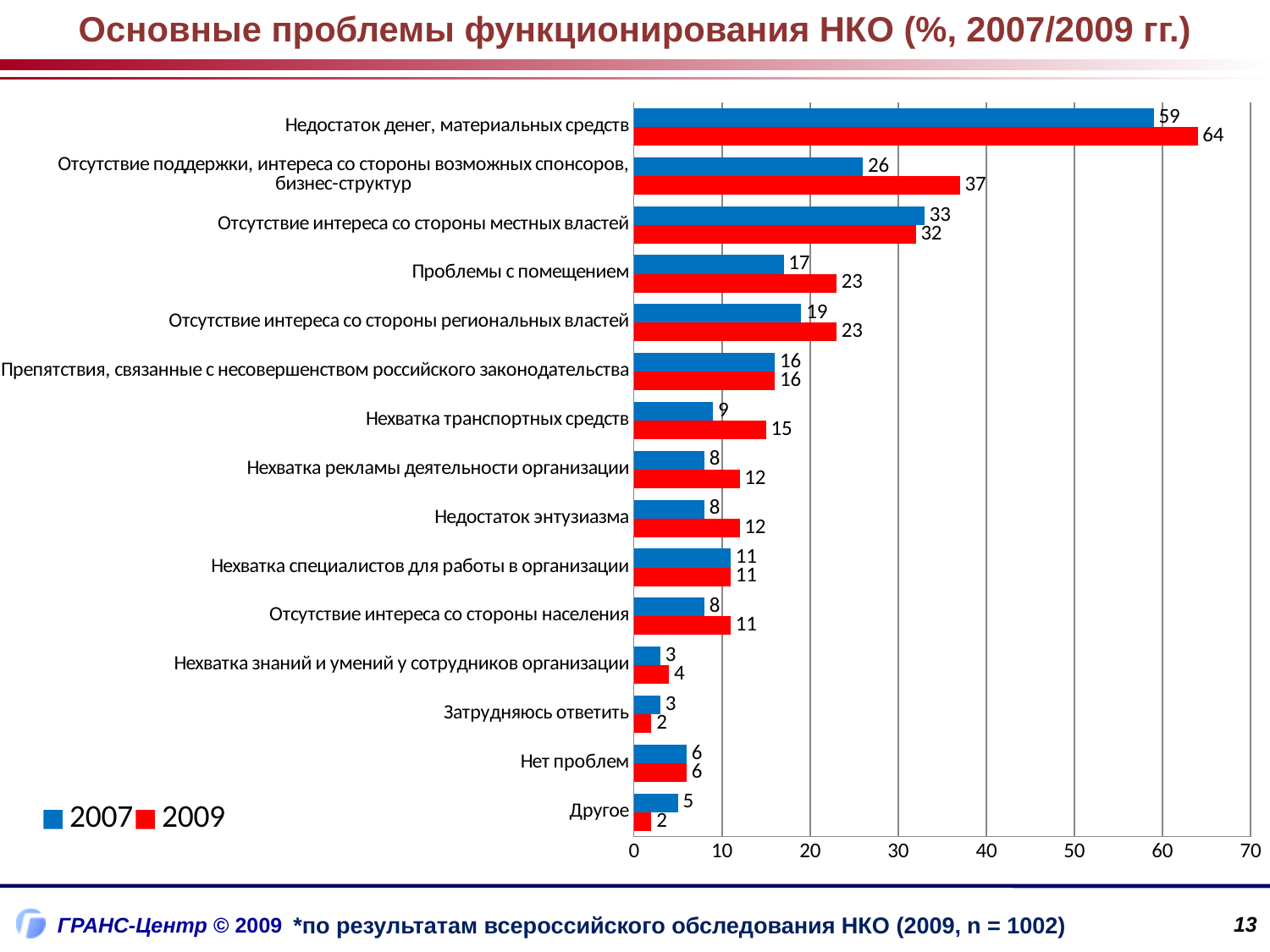
How many series does the legend list? 2 What is the 2007 value for "Отсутствие поддержки, интереса со стороны возможных спонсоров, бизнес-структур"? 26 What is the 2009 value for "Нехватка транспортных средств"? 15 Which colour represents the 2009 series in the legend? Red What kind of chart is shown on the slide? Bar chart What is the difference between the 2009 and 2007 values for "Отсутствие поддержки, интереса со стороны возможных спонсоров, бизнес-структур"? 11 For "Отсутствие интереса со стороны местных властей", which year has the larger value, 2007 or 2009? 2007 How many categories are shown on the chart? 15 For "Другое", which year has the larger value, 2007 or 2009? 2007 Which category has the highest 2007 value? Недостаток денег, материальных средств What is the difference between the 2007 and 2009 values for "Проблемы с помещением"? 6 What is the 2009 value for "Недостаток денег, материальных средств"? 64